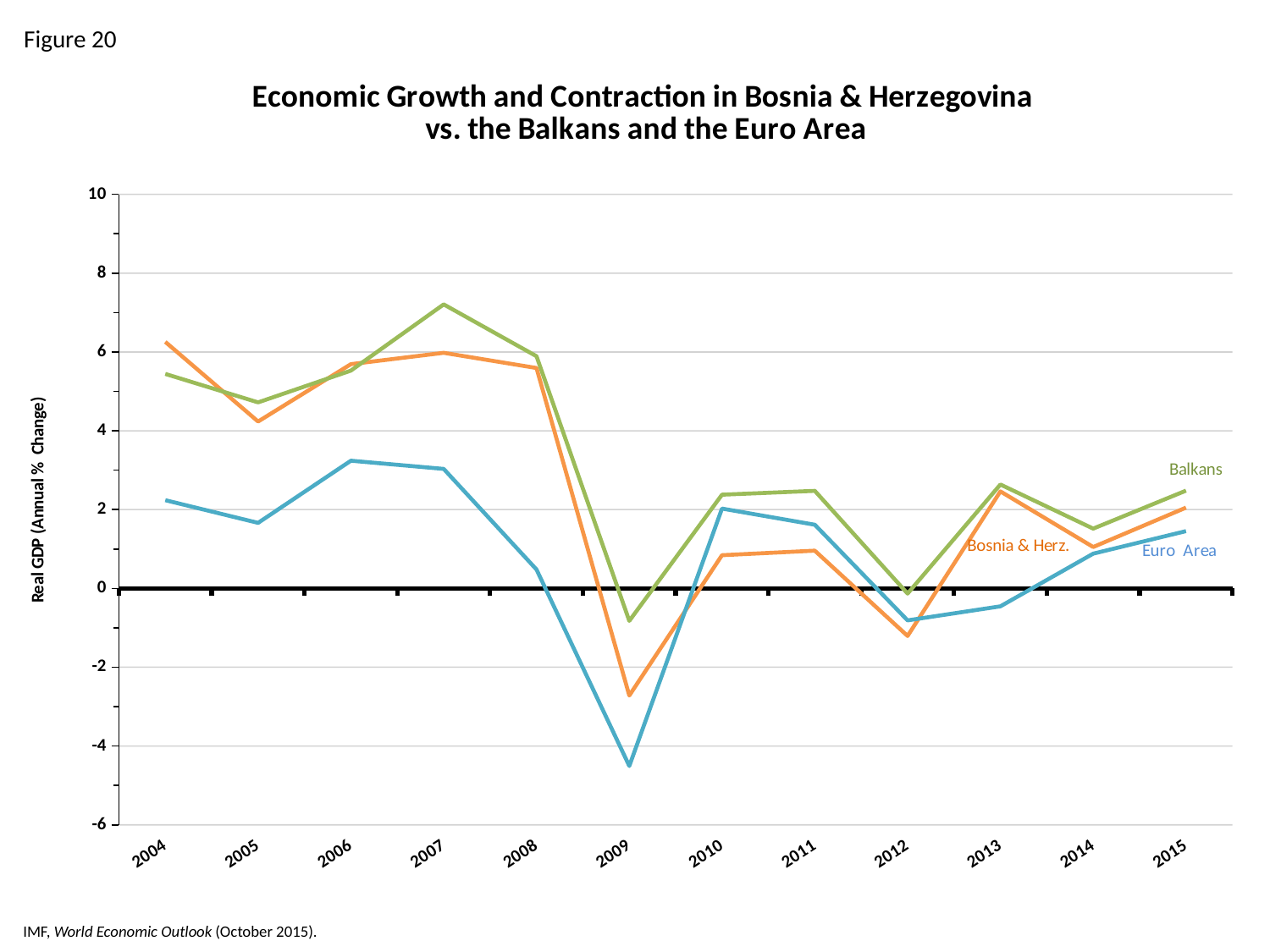
Is the Euro Area value for 2009 greater or less than -4? less Is the Bosnia & Herz. value for 2009 greater or less than -2? less In 2009, which series has the lowest value? Euro Area How many series are plotted on the chart? 3 Is the Bosnia & Herz. value for 2012 greater or less than 0? less How many years are plotted along the x axis? 12 What kind of chart is shown on the slide? line chart What is the label on the vertical axis? Real GDP (Annual % Change) In which year does the Euro Area series reach its lowest value? 2009 In which year does the Balkans series reach its highest value? 2007